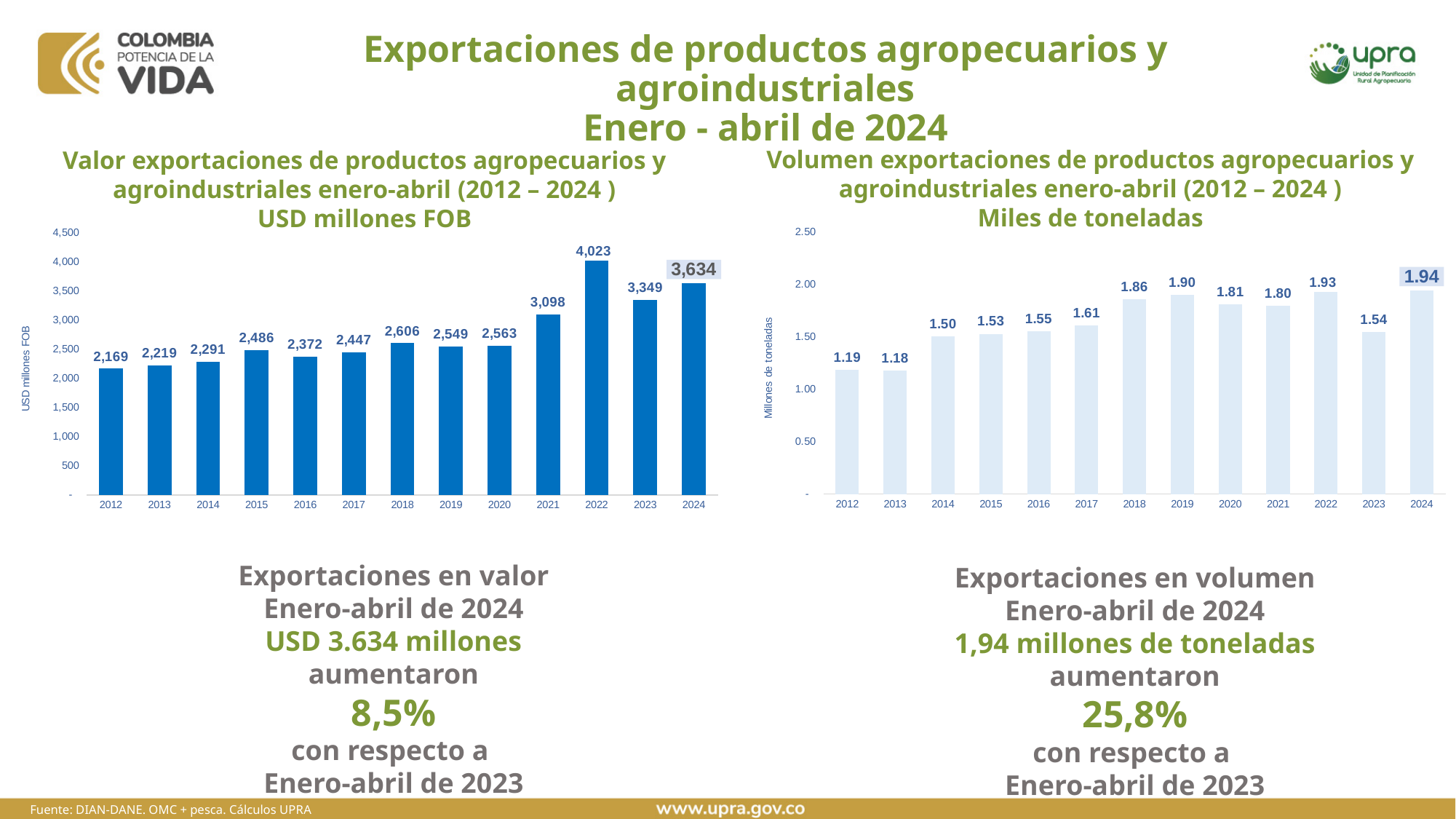
In the left chart (Valor exportaciones), what is the value for 2024? 3,634 In the left chart (Valor exportaciones), which year has the highest value? 2022 In the right chart (Volumen exportaciones), what is the difference between the values for 2024 and 2023? 0.40 In the right chart (Volumen exportaciones), which is larger, the value for 2018 or the value for 2023? 2018 In the left chart (Valor exportaciones), what is the difference between the values for 2024 and 2023? 285 What is the y-axis label of the left chart (Valor exportaciones)? USD millones FOB In the right chart (Volumen exportaciones), what is the value for 2019? 1.90 What kind of chart is the right chart (Volumen exportaciones)? bar chart How many years are shown on the x axis of the left chart (Valor exportaciones)? 13 In the left chart (Valor exportaciones), which year has the lowest value? 2012 In the left chart (Valor exportaciones), is the value for 2021 greater or less than 3,000? greater In the right chart (Volumen exportaciones), is the value for 2013 greater or less than 1.50? less